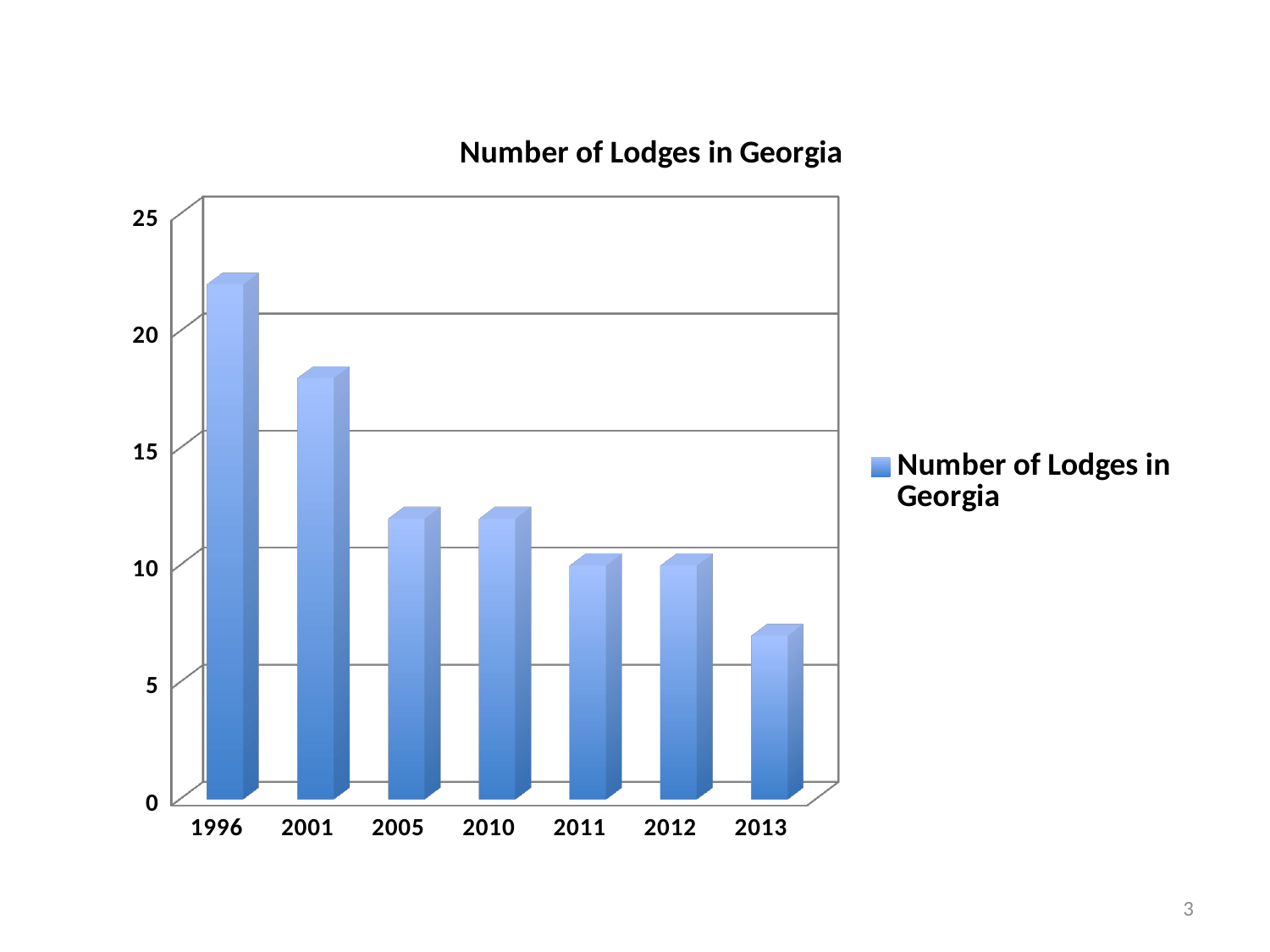
Which year has a larger value, 1996 or 2001? 1996 Is the value for 2005 greater or less than 15? less Is the value for 2001 greater or less than 20? less Do the values generally rise or fall from 1996 to 2013? fall Is the value for 1996 greater or less than 20? greater What is the title of the chart? Number of Lodges in Georgia What kind of chart is shown on the slide? bar chart Which year has the lowest number of lodges in Georgia? 2013 Which year has the highest number of lodges in Georgia? 1996 How many series does the legend list? 1 How many years are shown on the x axis of the chart? 7